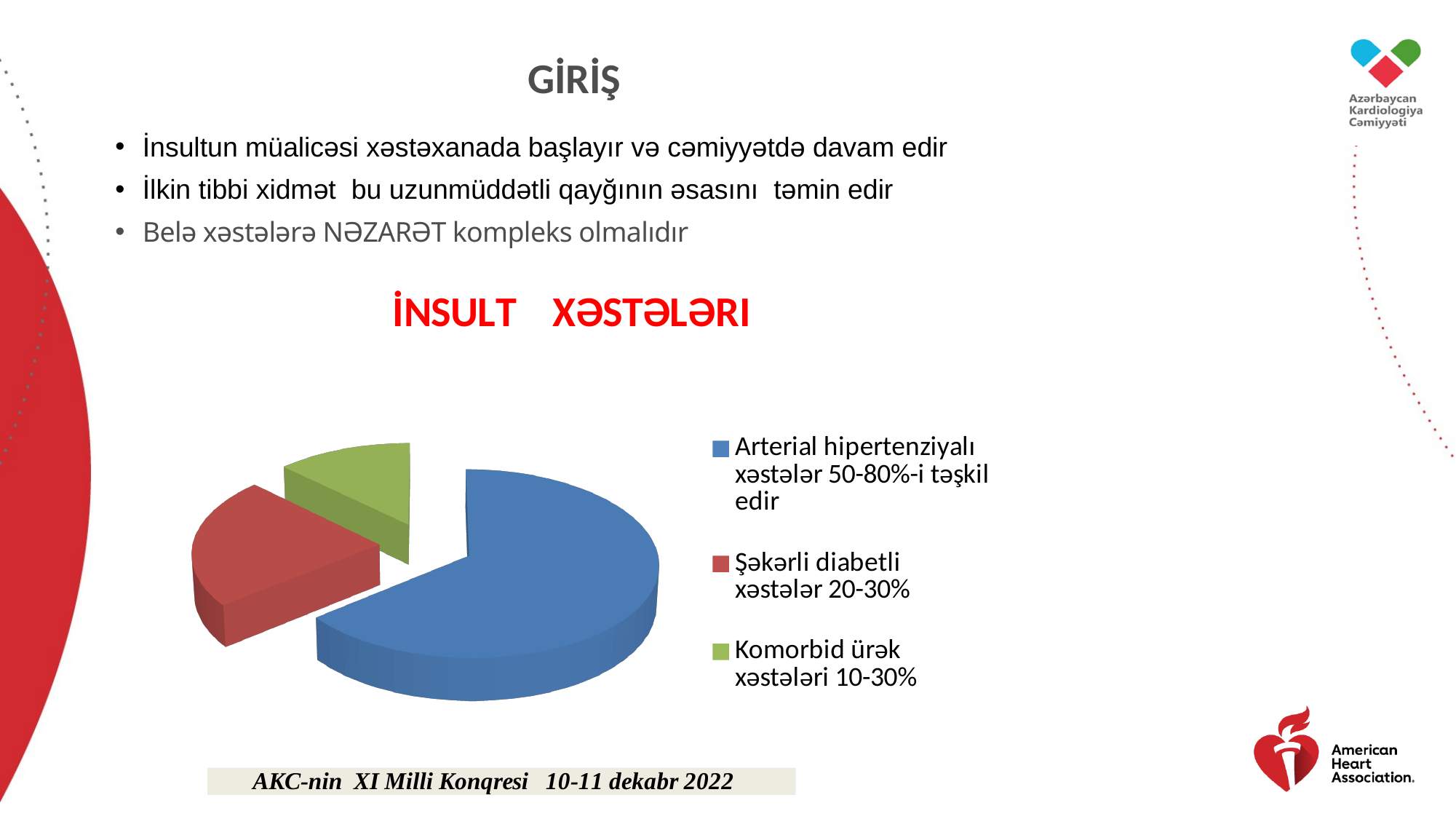
Which slice is larger: Şəkərli diabetli xəstələr or Komorbid ürək xəstələri? Şəkərli diabetli xəstələr Which category has the smallest slice in the pie chart? Komorbid ürək xəstələri Which category has the largest slice in the pie chart? Arterial hipertenziyalı xəstələr What kind of chart is shown on the slide? pie chart What percentage range does the legend give for Komorbid ürək xəstələri? 10-30% What is the title shown above the pie chart? İNSULT XƏSTƏLƏRI What colour is the slice for Şəkərli diabetli xəstələr? red How many slices does the pie chart have? 3 What percentage range does the legend give for Şəkərli diabetli xəstələr? 20-30% Which slice is larger: Arterial hipertenziyalı xəstələr or Şəkərli diabetli xəstələr? Arterial hipertenziyalı xəstələr What percentage range does the legend give for Arterial hipertenziyalı xəstələr? 50-80% How many entries does the legend of the pie chart list? 3